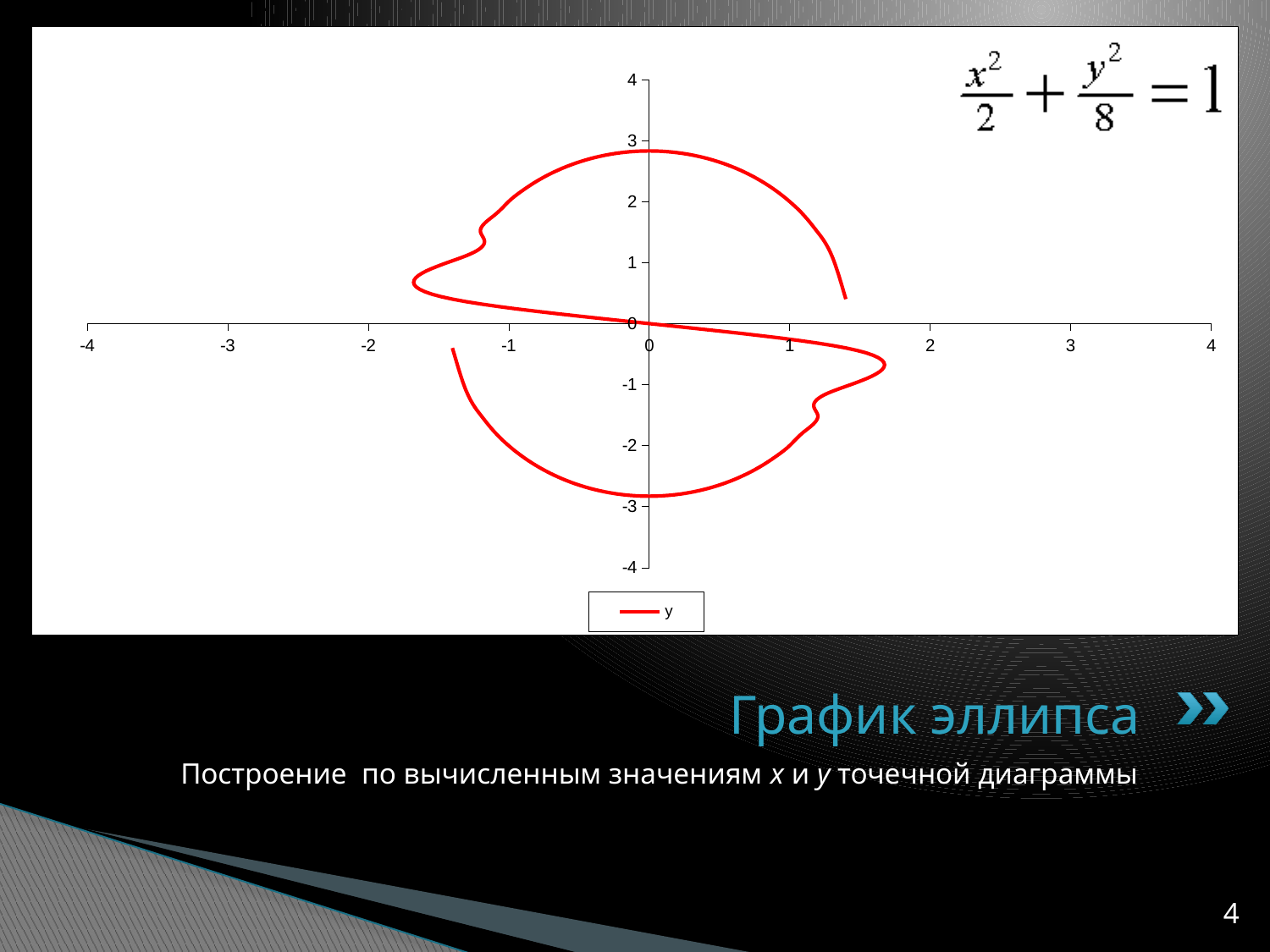
Is the lowest y value reached by the curve greater or less than -2? less Is the smallest x value reached by the curve greater or less than -2? greater What is the minimum value shown on the y axis? -4 How many series does the chart legend list? 1 What colour is the plotted curve? red Is the largest x value reached by the curve greater or less than 2? less What is the name of the series shown in the chart legend? y What is the maximum value shown on the x axis? 4 What kind of chart is shown on the slide? scatter chart with a smooth line